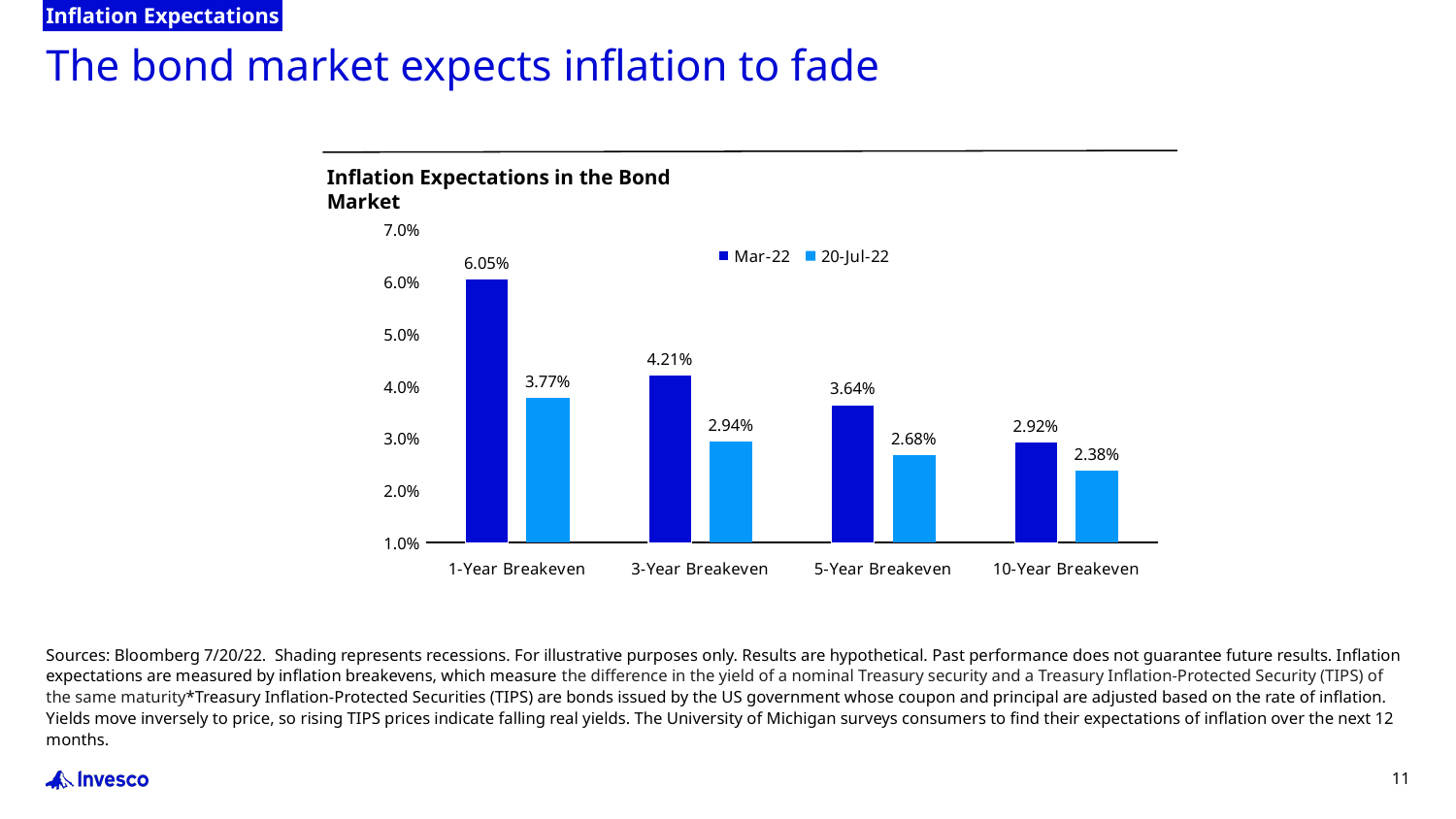
Which is larger: the 20-Jul-22 value for the 1-Year Breakeven or the Mar-22 value for the 5-Year Breakeven? 20-Jul-22 value for the 1-Year Breakeven How many categories are shown on the x axis? 4 What is the 20-Jul-22 value for the 3-Year Breakeven? 2.94% What is the difference between the Mar-22 and 20-Jul-22 values for the 1-Year Breakeven? 2.28% Do the Mar-22 values rise or fall from the 1-Year Breakeven to the 10-Year Breakeven? Fall Which category has the lowest 20-Jul-22 value? 10-Year Breakeven What is the difference between the Mar-22 and 20-Jul-22 values for the 5-Year Breakeven? 0.96% What is the 20-Jul-22 value for the 10-Year Breakeven? 2.38% How many series does the legend list? 2 Which category has the highest Mar-22 value? 1-Year Breakeven What kind of chart is shown on the slide? Bar chart What is the Mar-22 value for the 1-Year Breakeven? 6.05%